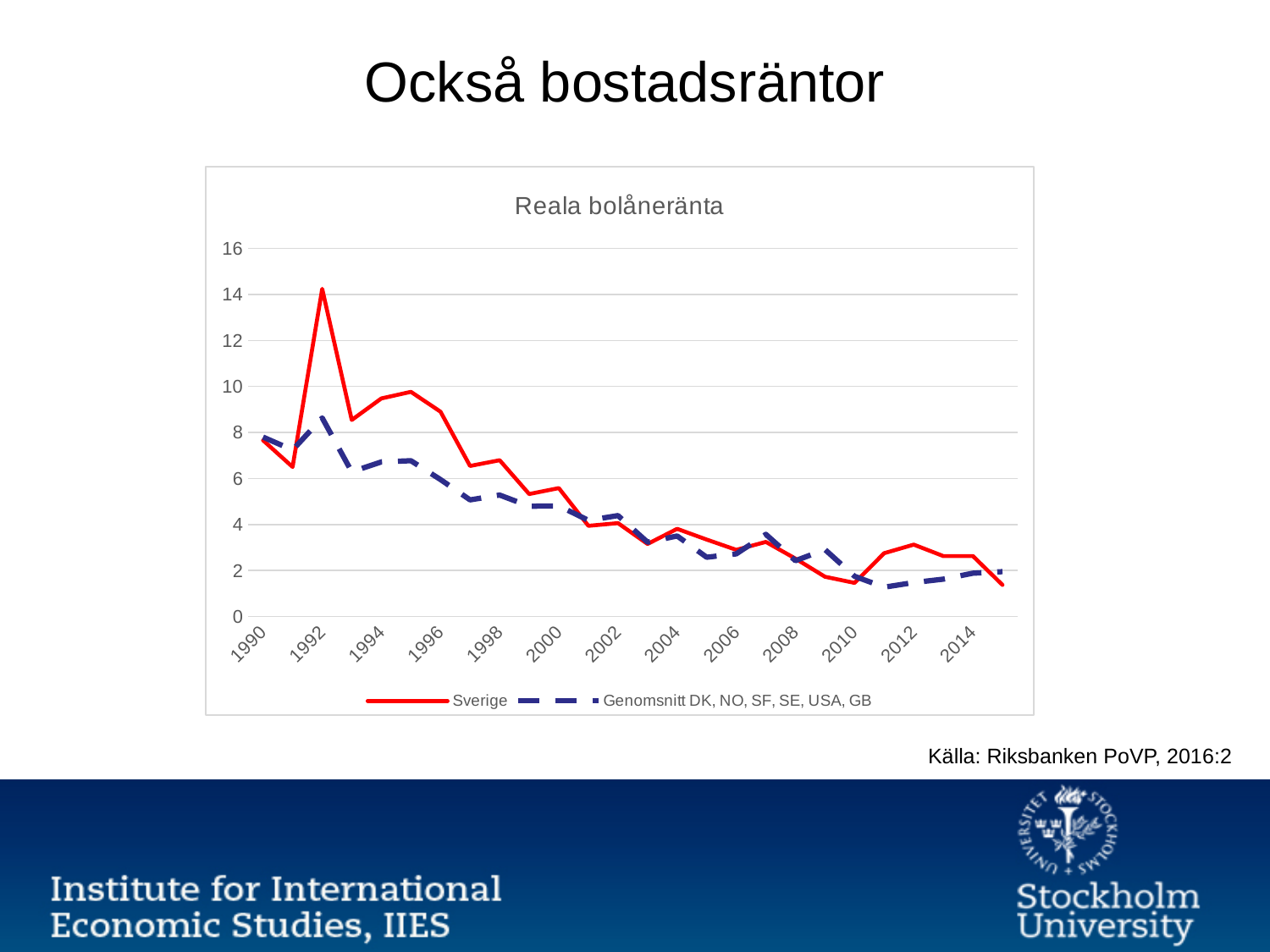
In 1992, which series is higher, Sverige or Genomsnitt DK, NO, SF, SE, USA, GB? Sverige Is the value for Sverige in 1992 greater or less than 12? greater Do the values for Sverige generally rise or fall from 1990 to 2014? fall How many year labels are shown on the x axis? 13 In 1998, which series is higher, Sverige or Genomsnitt DK, NO, SF, SE, USA, GB? Sverige How many series does the legend list? 2 Is the value for Sverige in 2014 greater or less than 4? less Is the value for Genomsnitt DK, NO, SF, SE, USA, GB in 1990 greater or less than 6? greater What kind of chart is shown on the slide? line chart What is the title of the chart? Reala bolåneränta Which colour is used for the Sverige line? red In which year does the Sverige line reach its highest value? 1992